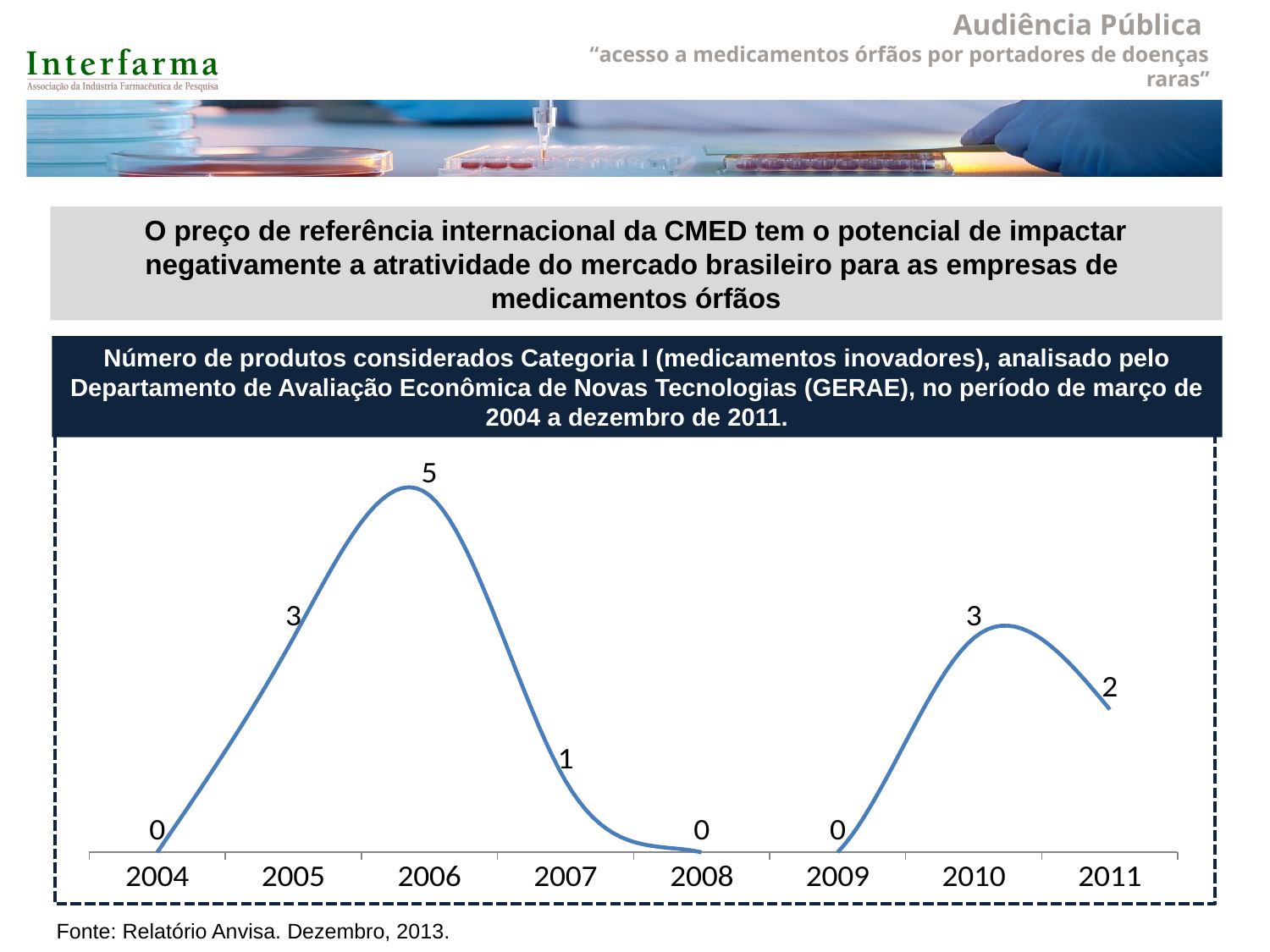
How many years are shown on the x axis? 8 What kind of chart is this? line chart What is the value for 2007? 1 Which year has the highest value? 2006 What is the difference between the values for 2006 and 2005? 2 What is the value for 2006? 5 What is the value for 2011? 2 Do the values rise or fall from 2006 to 2008? fall What is the difference between the values for 2010 and 2011? 1 Which is larger, the value for 2005 or the value for 2007? 2005 How many years have a value of 0? 3 What is the value for 2010? 3